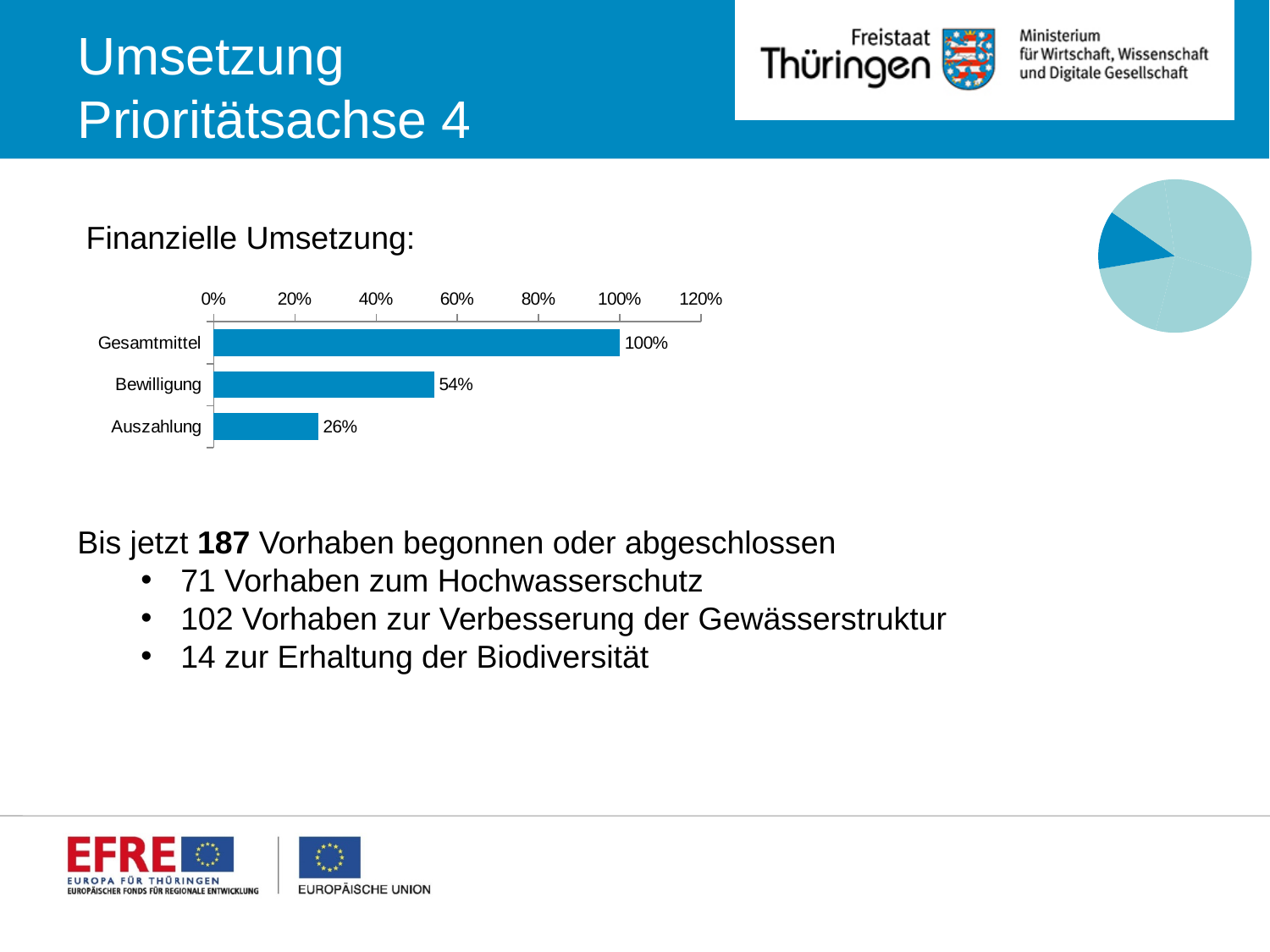
In the bar chart under "Finanzielle Umsetzung", which category has the highest value? Gesamtmittel In the bar chart under "Finanzielle Umsetzung", what is the value for Bewilligung? 54% In the bar chart under "Finanzielle Umsetzung", which category has the lowest value? Auszahlung In the bar chart under "Finanzielle Umsetzung", what is the difference between the values for Bewilligung and Auszahlung? 28% What kind of chart is shown under "Finanzielle Umsetzung"? bar chart In the bar chart under "Finanzielle Umsetzung", is the value for Bewilligung greater or less than 40%? greater In the bar chart under "Finanzielle Umsetzung", which is larger, the value for Bewilligung or the value for Auszahlung? Bewilligung In the bar chart under "Finanzielle Umsetzung", what is the highest tick value shown on the percentage axis? 120% In the bar chart under "Finanzielle Umsetzung", what is the difference between the values for Gesamtmittel and Bewilligung? 46% In the bar chart under "Finanzielle Umsetzung", what is the value for Gesamtmittel? 100% In the bar chart under "Finanzielle Umsetzung", what is the value for Auszahlung? 26% In the bar chart under "Finanzielle Umsetzung", how many categories are shown? 3